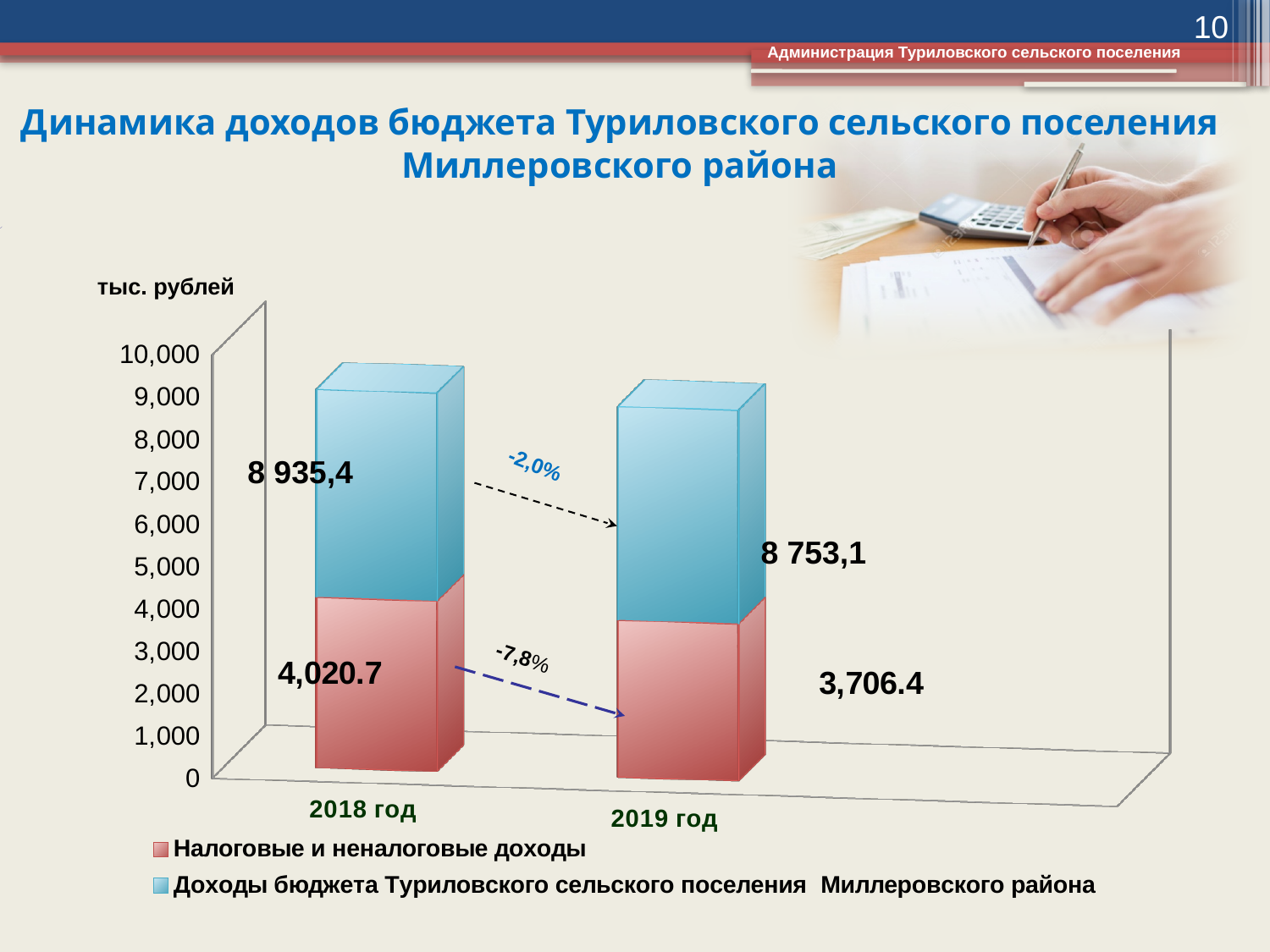
What percentage change is shown by the arrow between the "Доходы бюджета" values for 2018 and 2019? -2,0% What percentage change is shown by the arrow between the "Налоговые и неналоговые доходы" values for 2018 and 2019? -7,8% How many series does the chart legend list? 2 What value is labelled for "Доходы бюджета Туриловского сельского поселения Миллеровского района" in 2018 год? 8 935,4 How many years (categories) are shown on the x axis of the chart? 2 What kind of chart is shown on the slide? bar chart Which year has the larger value for "Налоговые и неналоговые доходы", 2018 год or 2019 год? 2018 год What value is labelled for "Доходы бюджета Туриловского сельского поселения Миллеровского района" in 2019 год? 8 753,1 What value is labelled for "Налоговые и неналоговые доходы" in 2018 год? 4,020.7 By how much did "Налоговые и неналоговые доходы" decrease from 2018 год to 2019 год, based on the printed labels? 314.3 Do the values for "Налоговые и неналоговые доходы" rise or fall from 2018 год to 2019 год? fall What value is labelled for "Налоговые и неналоговые доходы" in 2019 год? 3,706.4